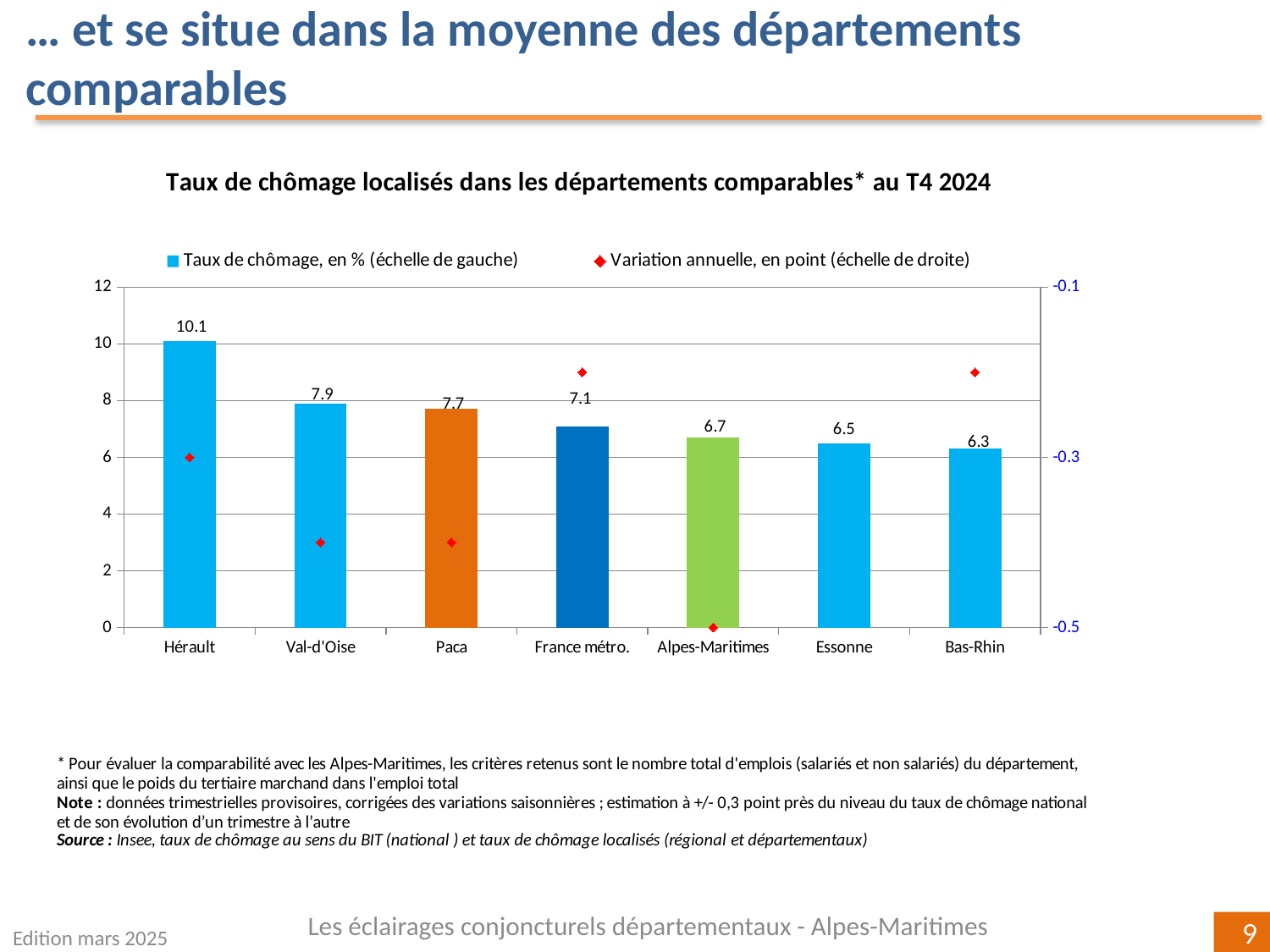
Which has a higher unemployment rate, Val-d'Oise or Essonne? Val-d'Oise Which department has the highest unemployment rate on the chart? Hérault What is the annual variation (Variation annuelle, en point) for Alpes-Maritimes? -0.5 Is the annual variation (Variation annuelle, en point) for France métro. greater or less than -0.3? greater How many series does the chart legend list? 2 Which category has the lowest unemployment rate on the chart? Bas-Rhin What is the unemployment rate (Taux de chômage, en %) for Alpes-Maritimes? 6.7 What is the unemployment rate (Taux de chômage, en %) for Hérault? 10.1 What is the title of the chart? Taux de chômage localisés dans les départements comparables* au T4 2024 How many categories are shown on the x axis of the chart? 7 What is the unemployment rate (Taux de chômage, en %) for France métro.? 7.1 What is the difference between the unemployment rates of Hérault and Bas-Rhin? 3.8